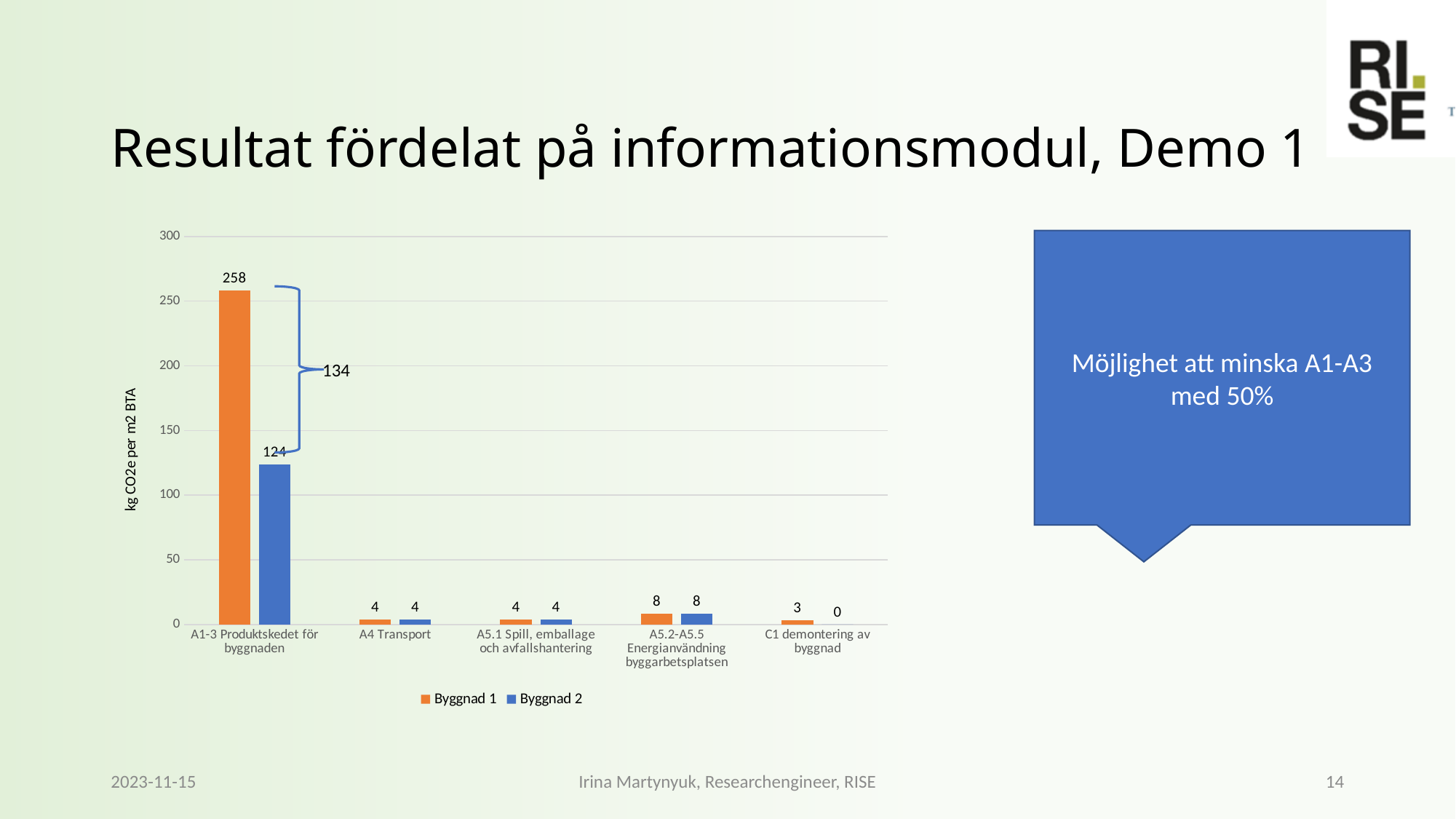
Which is larger in the C1 demontering av byggnad category, Byggnad 1 or Byggnad 2? Byggnad 1 What is the value for Byggnad 2 in the A5.2-A5.5 Energianvändning byggarbetsplatsen category? 8 What is the value for Byggnad 2 in the A1-3 Produktskedet för byggnaden category? 124 How many series does the chart legend list? 2 Which category has the lowest value for Byggnad 2? C1 demontering av byggnad What is the value for Byggnad 1 in the C1 demontering av byggnad category? 3 How many categories are shown on the x axis of the chart? 5 What type of chart is shown on the slide? Bar chart Is the value for Byggnad 1 in A1-3 Produktskedet för byggnaden greater or less than 250? greater Which category has the highest value for Byggnad 1? A1-3 Produktskedet för byggnaden What is the value for Byggnad 1 in the A1-3 Produktskedet för byggnaden category? 258 What is the difference between Byggnad 1 and Byggnad 2 in the A1-3 Produktskedet för byggnaden category? 134